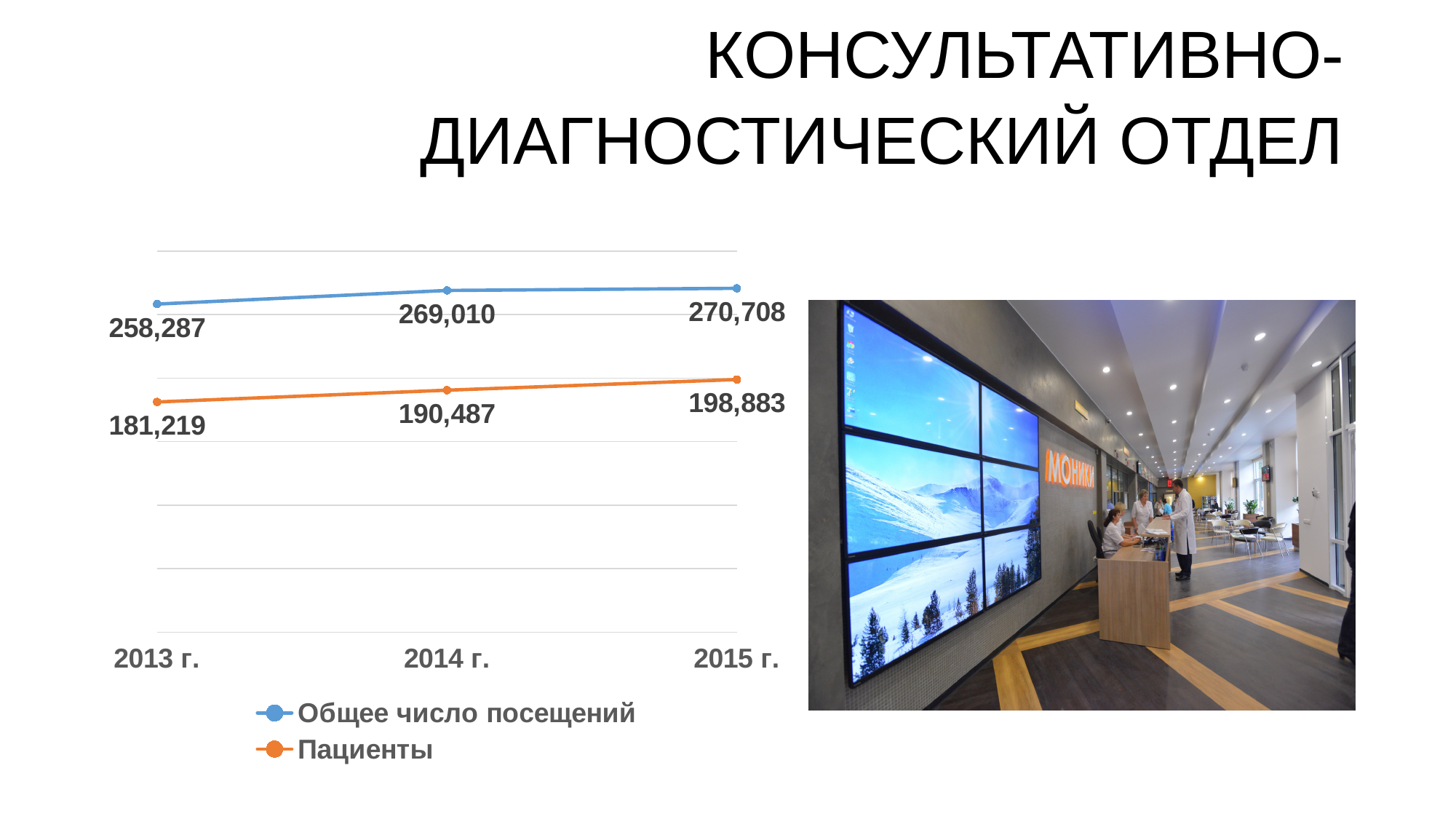
In which year is "Пациенты" lowest? 2013 г. What is the value of "Общее число посещений" in 2013 г.? 258,287 How many years are shown on the x axis of the chart? 3 What is the value of "Общее число посещений" in 2014 г.? 269,010 What is the value of "Пациенты" in 2014 г.? 190,487 What is the difference between "Общее число посещений" and "Пациенты" in 2014 г.? 78,523 What kind of chart is shown on the slide? Line chart In which year is "Общее число посещений" highest? 2015 г. How many series does the chart legend list? 2 What is the value of "Пациенты" in 2015 г.? 198,883 What is the difference between "Общее число посещений" in 2015 г. and in 2013 г.? 12,421 Which is larger in 2013 г.: "Общее число посещений" or "Пациенты"? Общее число посещений